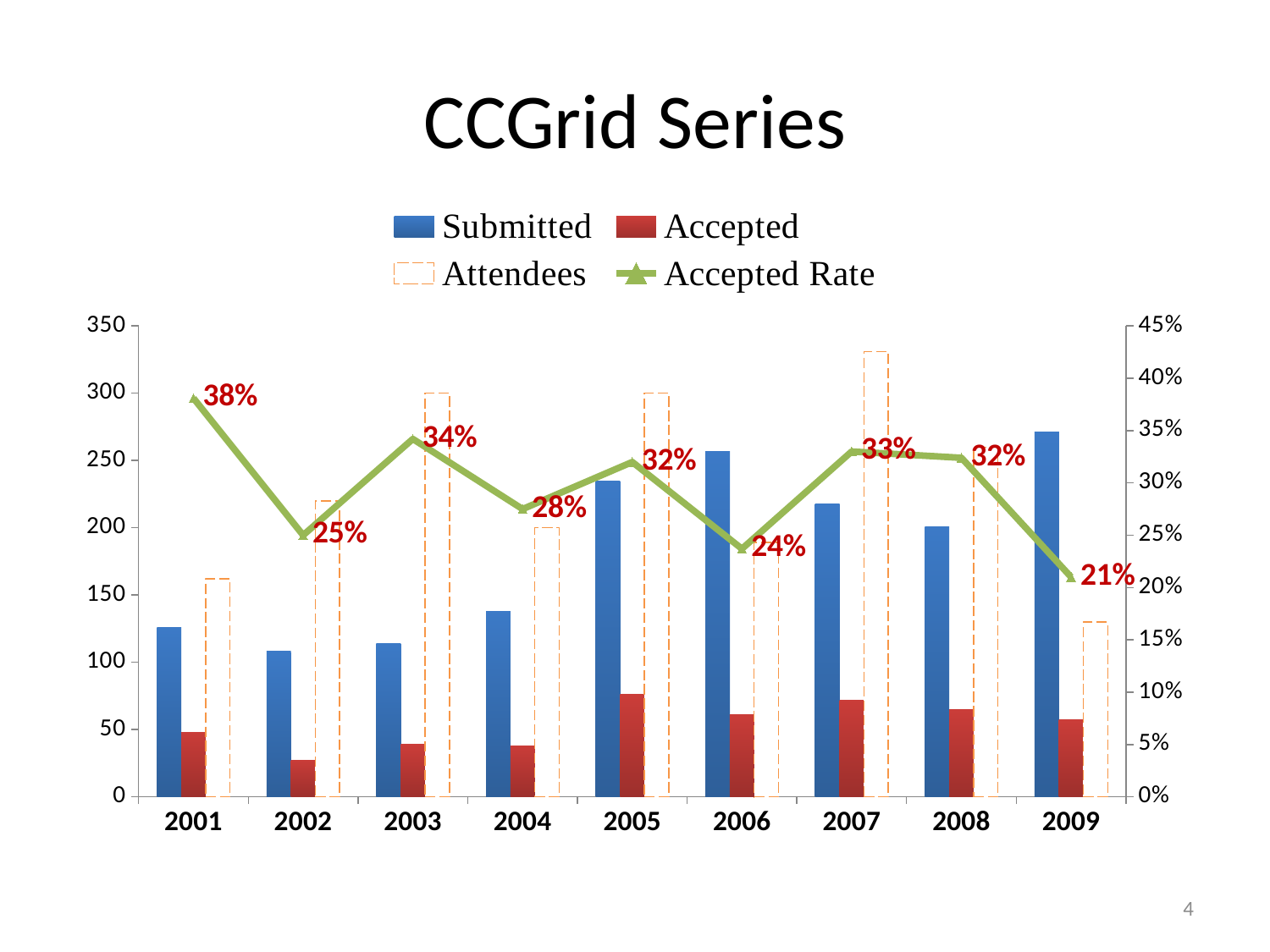
How many years are shown on the x axis? 9 Is the Submitted value for 2009 greater or less than 250? greater What is the Accepted Rate for 2001? 38% Which year has a higher Accepted Rate, 2003 or 2005? 2003 What is the Accepted Rate for 2006? 24% What is the difference between the Accepted Rate in 2001 and in 2009? 17 percentage points Is the Attendees value for 2007 greater or less than 300? greater How many series does the legend list? 4 Which year has the lowest Accepted Rate? 2009 Which year has the highest Accepted Rate? 2001 Is the Submitted value for 2002 greater or less than 150? less Does the Accepted Rate rise or fall from 2007 to 2009? fall